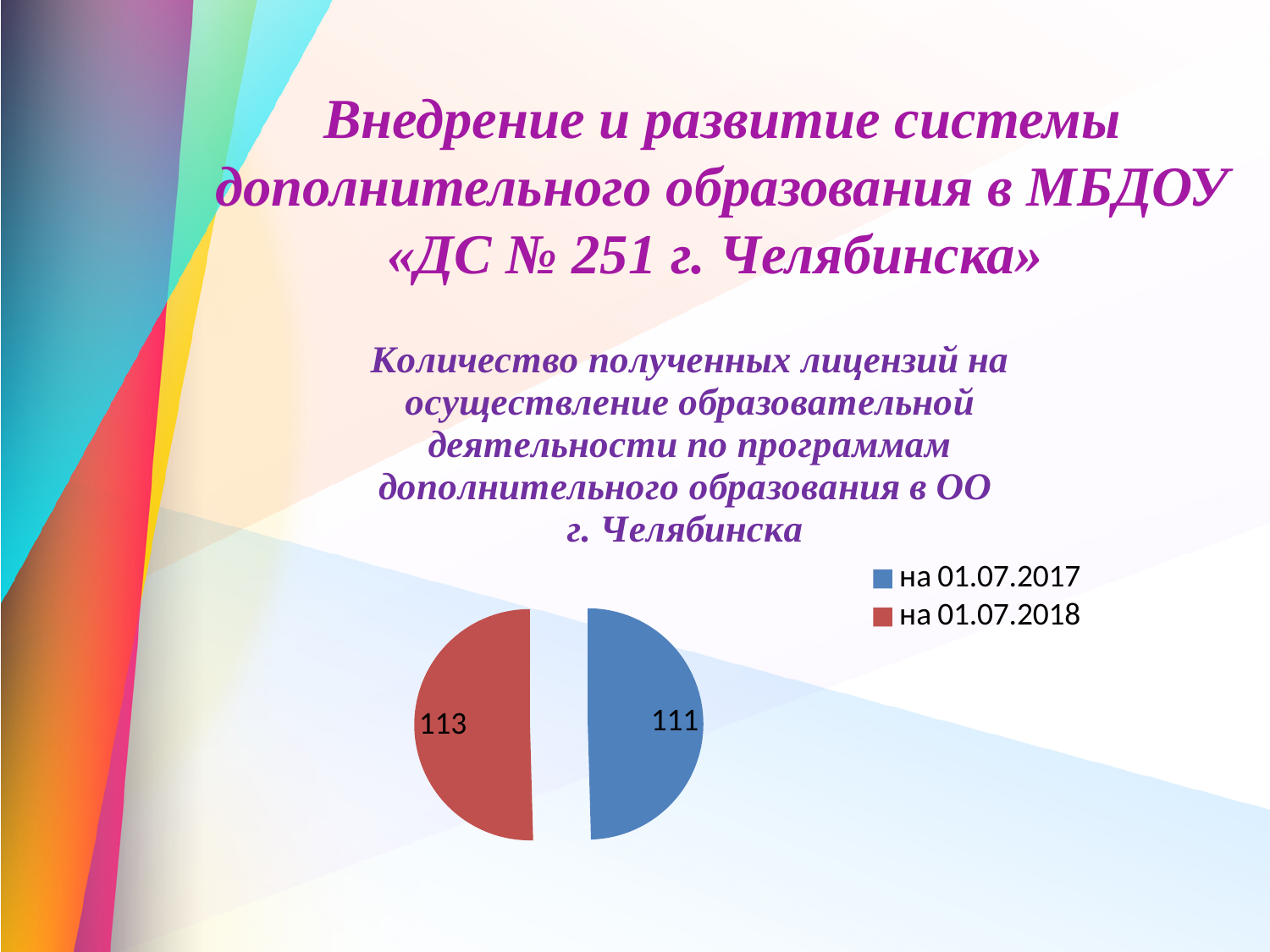
How many entries does the legend of the pie chart list? 2 What is the value for "на 01.07.2018" in the pie chart? 113 What is the total of the two values shown in the pie chart? 224 What is the value for "на 01.07.2017" in the pie chart? 111 Is the value for "на 01.07.2017" larger or smaller than the value for "на 01.07.2018"? smaller What kind of chart is shown on the slide? pie chart How many slices does the pie chart have? 2 Which category has the larger value in the pie chart? на 01.07.2018 What is the difference between the values for "на 01.07.2018" and "на 01.07.2017"? 2 Which colour represents "на 01.07.2017" in the pie chart? blue Which colour represents "на 01.07.2018" in the pie chart? red Which category has the smaller value in the pie chart? на 01.07.2017